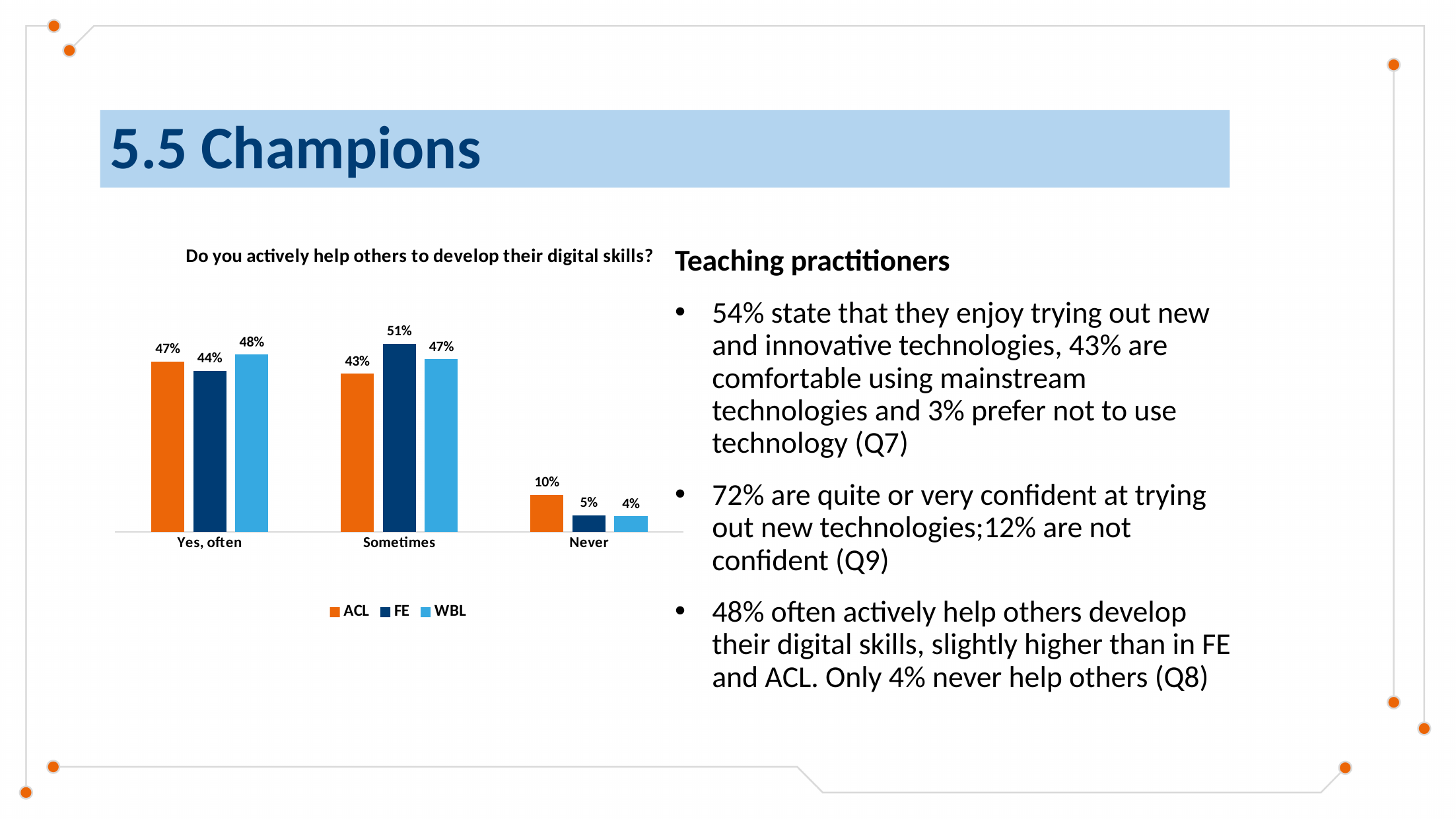
Which is larger: the WBL value for "Yes, often" or the WBL value for "Sometimes"? Yes, often Which category has the lowest ACL value? Never Which series has the highest value for "Sometimes"? FE What kind of chart is shown? Bar chart What is the WBL value for "Never"? 4% What is the ACL value for "Yes, often"? 47% How many series does the legend list? 3 How many categories are shown on the x axis? 3 Which series is shown in orange? ACL What is the difference between the ACL and FE values for "Never"? 5% What is the FE value for "Sometimes"? 51% What is the title of the chart? Do you actively help others to develop their digital skills?